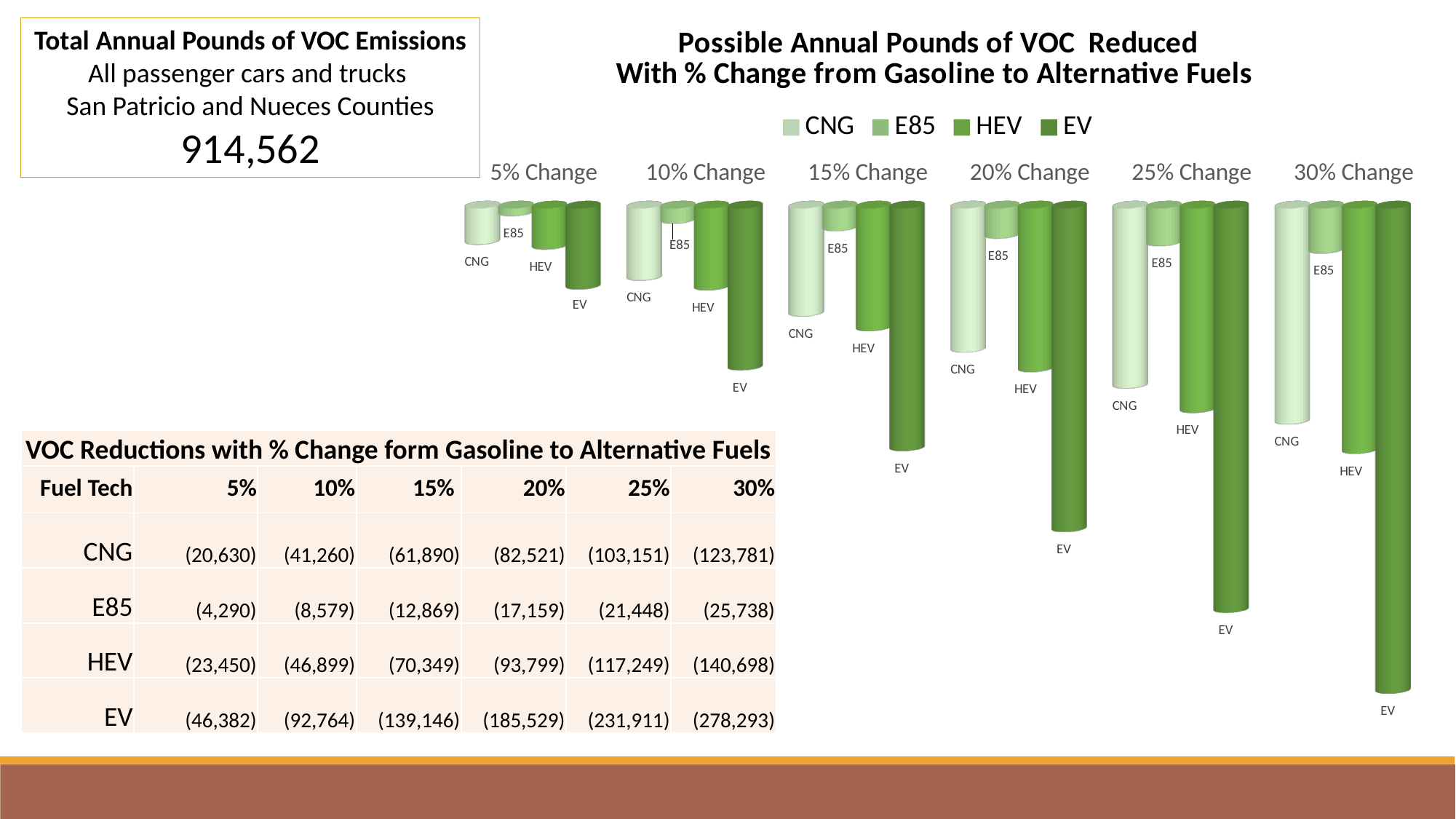
In the VOC Reduced chart, which fuel technology has the largest reduction at 30% Change? EV Which series is shown in the lightest green in the VOC Reduced chart legend? CNG What is the VOC reduction for E85 at 25% Change? (21,448) What is the VOC reduction for EV at 30% Change? (278,293) How many series does the legend of the VOC Reduced chart list? 4 At 20% Change, which is larger: the CNG reduction or the HEV reduction? HEV What kind of chart is "Possible Annual Pounds of VOC Reduced With % Change from Gasoline to Alternative Fuels"? Bar chart How many % Change categories are shown along the x axis of the VOC Reduced chart? 6 At 30% Change, how much larger is the EV reduction than the HEV reduction? 137,595 In the VOC Reduced chart, do the EV bars get longer or shorter as the % Change increases from 5% to 30%? Longer What is the VOC reduction for CNG at 10% Change? (41,260) In the VOC Reduced chart, which fuel technology has the smallest reduction at 15% Change? E85